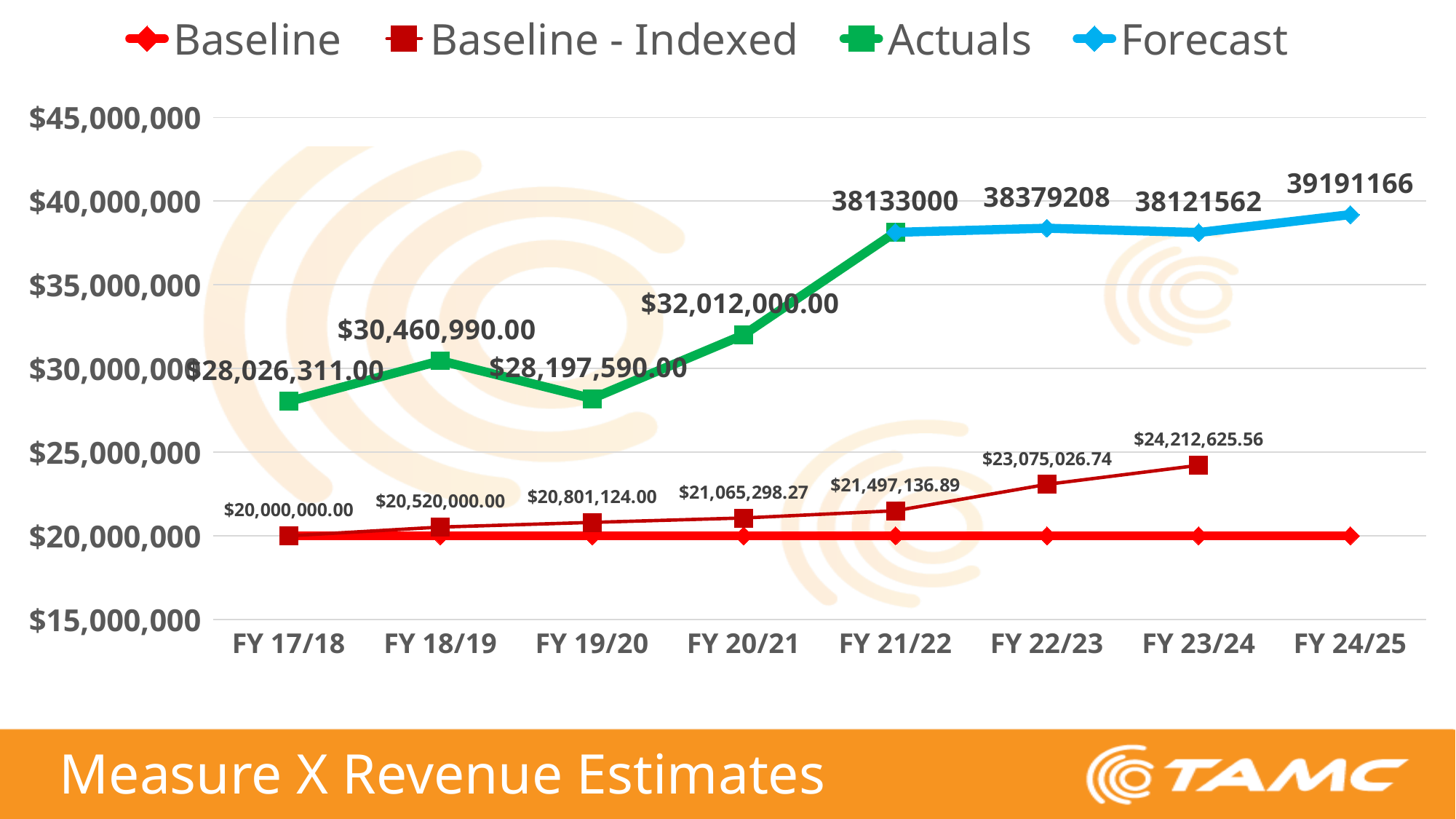
Is the Baseline value for FY 24/25 greater or less than $25,000,000? less What is the Forecast value for FY 24/25? 39191166 Does the Baseline - Indexed series rise or fall from FY 17/18 to FY 23/24? rise What is the Actuals value for FY 18/19? $30,460,990.00 Which is larger, the Forecast value for FY 22/23 or for FY 23/24? FY 22/23 What is the difference between the Actuals values for FY 20/21 and FY 19/20? $3,814,410.00 What kind of chart is shown on the slide? line chart What is the Baseline - Indexed value for FY 23/24? $24,212,625.56 How many series does the legend list? 4 In which fiscal year is the Forecast series highest? FY 24/25 In which fiscal year is the Actuals series lowest? FY 17/18 How many fiscal years are shown on the x axis? 8